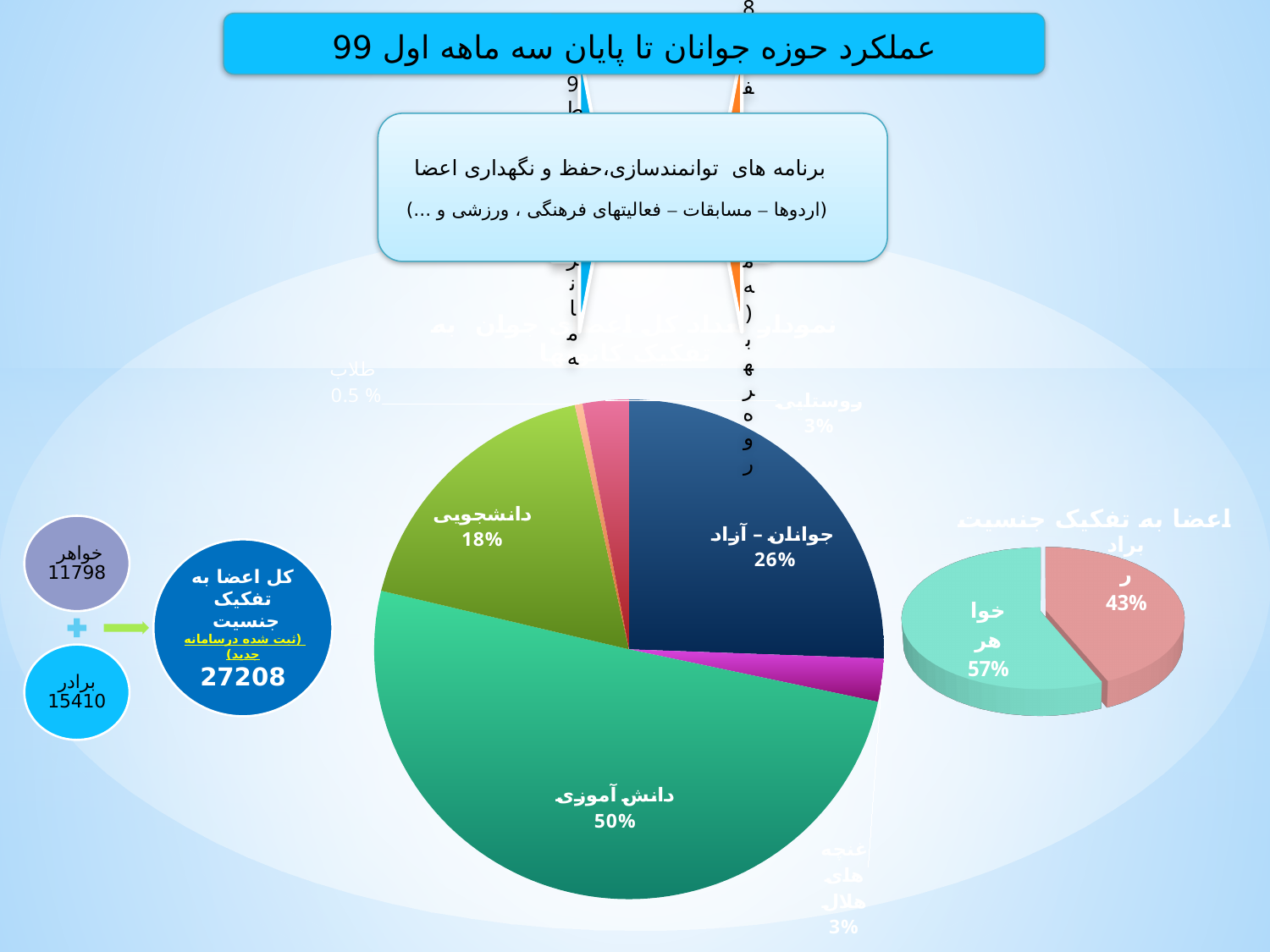
In the pie chart titled اعضا به تفکیک جنسیت, what is the difference between the shares of خواهر and برادر? 14% In the large central pie chart, what share is labelled for دانشجویی? 18% What kind of chart is the chart titled اعضا به تفکیک جنسیت on the right? pie chart In the large central pie chart, what share is labelled for جوانان - آزاد? 26% In the pie chart titled اعضا به تفکیک جنسیت, what share is labelled for برادر? 43% In the large central pie chart, what share is labelled for دانش آموزی? 50% In the pie chart titled اعضا به تفکیک جنسیت, how many slices are there? 2 In the pie chart titled اعضا به تفکیک جنسیت, what share is labelled for خواهر? 57% In the large central pie chart, which category has the smallest slice? طلاب In the large central pie chart, which category has the largest slice? دانش آموزی In the large central pie chart, which is larger: the share of جوانان - آزاد or the share of دانشجویی? جوانان - آزاد In the large central pie chart, what is the difference between the shares of دانش آموزی and جوانان - آزاد? 24%